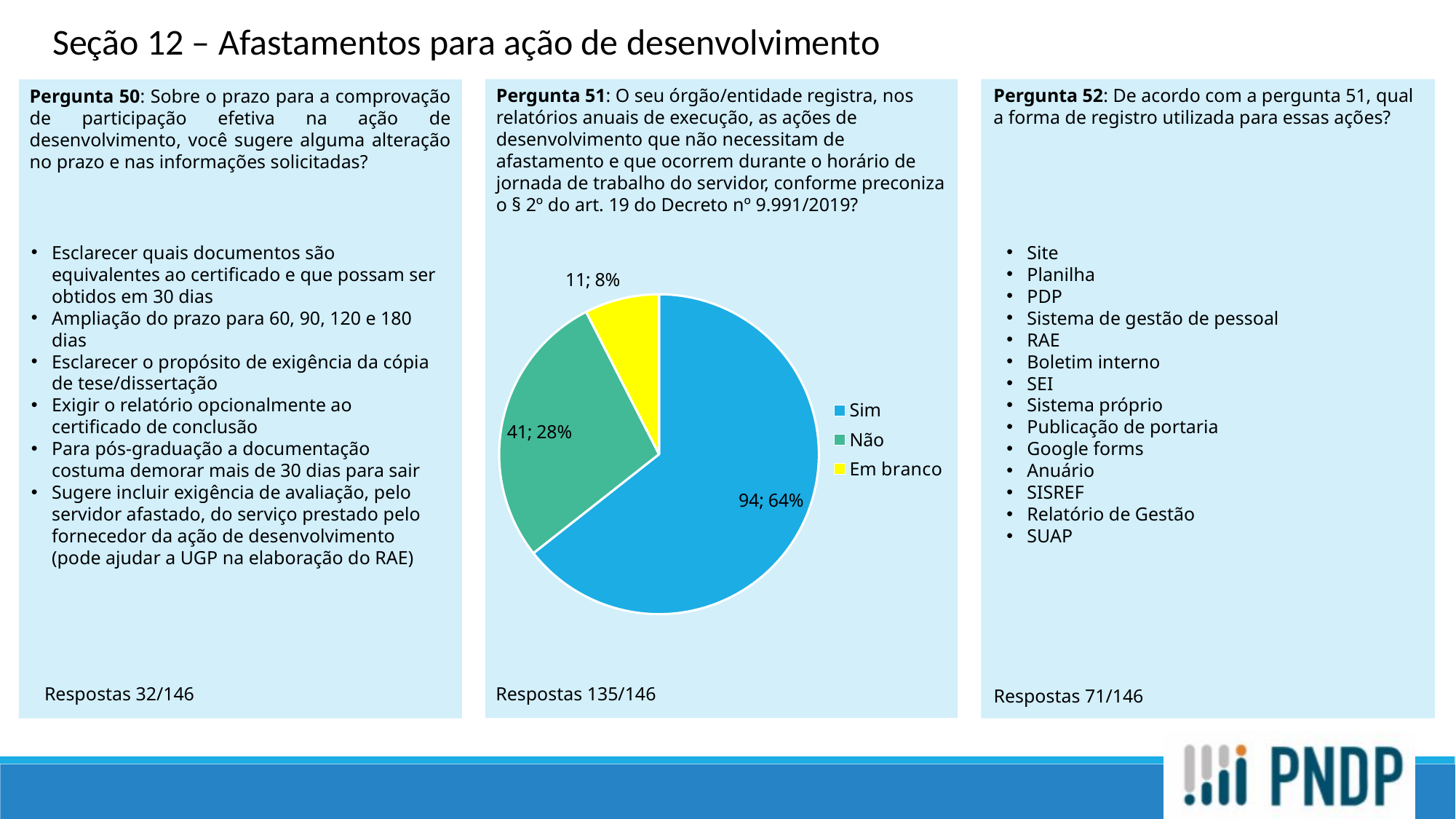
What is the count shown for the 'Em branco' slice? 11 What kind of chart is shown under Pergunta 51? pie chart Which category has the largest slice in the pie chart? Sim What percentage does the 'Sim' slice represent? 64% What is the count shown for the 'Sim' slice of the pie chart? 94 What colour is the 'Em branco' slice in the pie chart? yellow What is the difference between the counts for 'Sim' and 'Não'? 53 How many slices does the pie chart under Pergunta 51 have? 3 Which is larger, the count for 'Não' or the count for 'Em branco'? Não What percentage does the 'Não' slice represent in the pie chart? 28% Which category has the smallest slice in the pie chart? Em branco How many entries does the legend of the pie chart list? 3